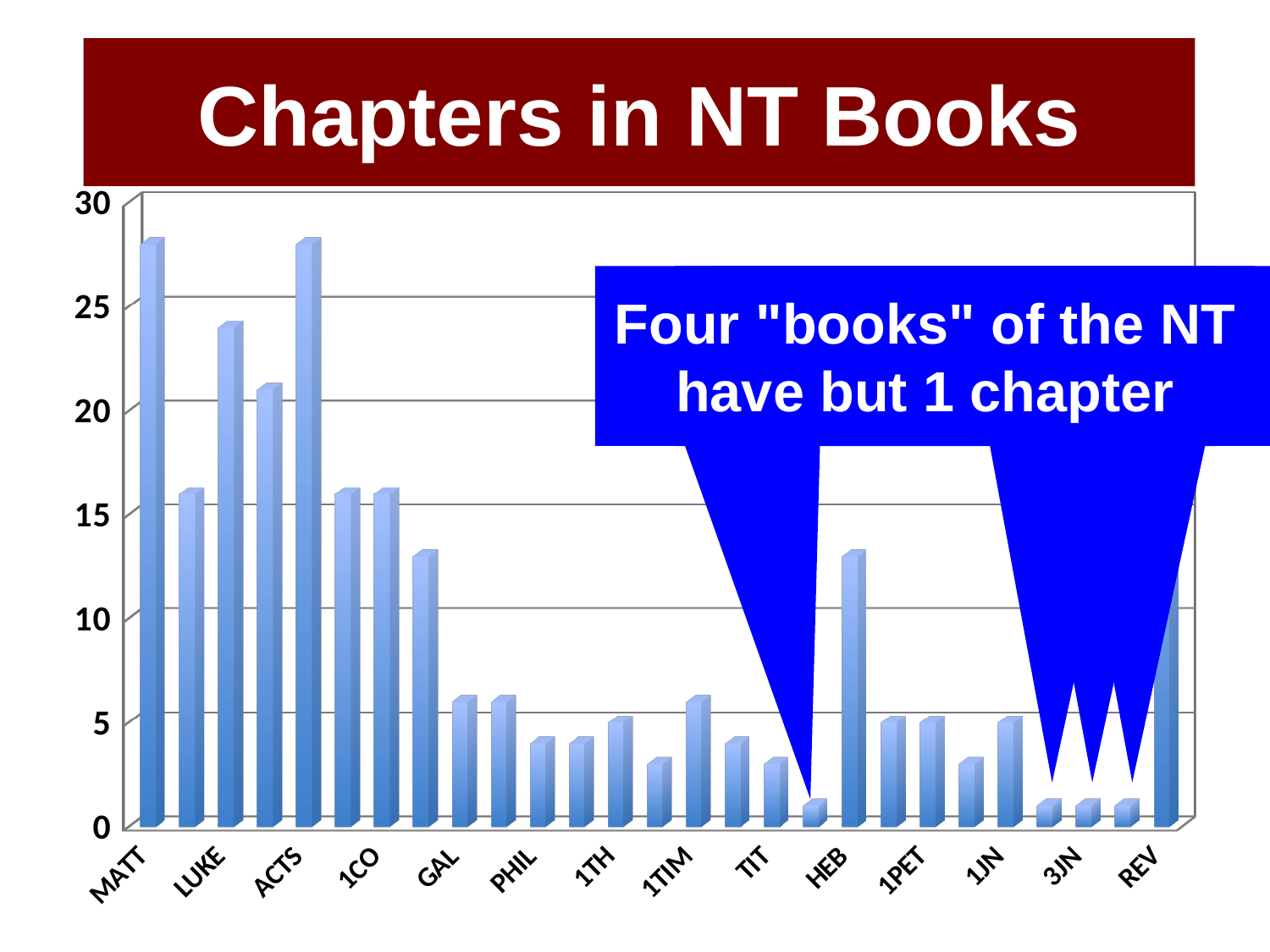
Is the value for LUKE greater or less than 20? greater How many bars are plotted in the chart? 27 Is the value for MATT greater or less than 25? greater Is the value for 3JN greater or less than 5? less Which has the larger value, LUKE or HEB? LUKE What kind of chart is shown on the slide? bar chart What is the title of the chart? Chapters in NT Books Which has the larger value, GAL or REV? REV According to the callout on the chart, how many NT books have only 1 chapter? Four